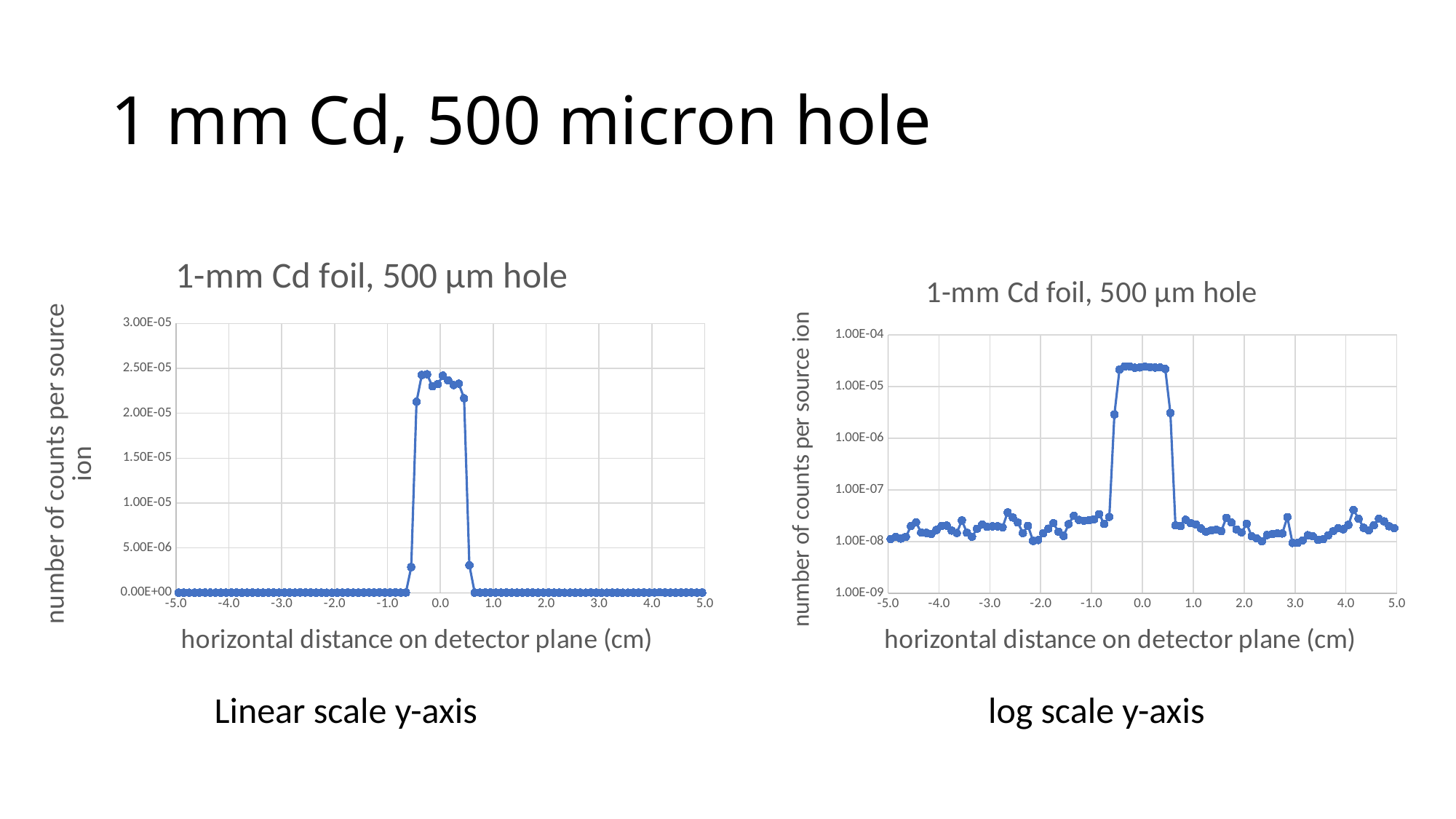
On the right chart (log scale y-axis), is the value at horizontal distance 0.0 greater or less than 1.00E-05? greater On the right chart (log scale y-axis), is the value at horizontal distance -2.0 greater or less than 1.00E-09? greater On the left chart (linear scale y-axis), is the value at horizontal distance -3.0 greater or less than 5.00E-06? less What kind of chart is the right chart (log scale y-axis)? line chart On the left chart (linear scale y-axis), do the values rise or fall as the horizontal distance goes from 0.0 to 1.0? fall What is the x-axis label of the left chart (linear scale y-axis)? horizontal distance on detector plane (cm) What kind of chart is the left chart titled '1-mm Cd foil, 500 µm hole' (linear scale y-axis)? line chart On the left chart (linear scale y-axis), is the value at horizontal distance 0.0 larger or smaller than the value at horizontal distance 2.0? larger What is the title of the right chart (log scale y-axis)? 1-mm Cd foil, 500 µm hole